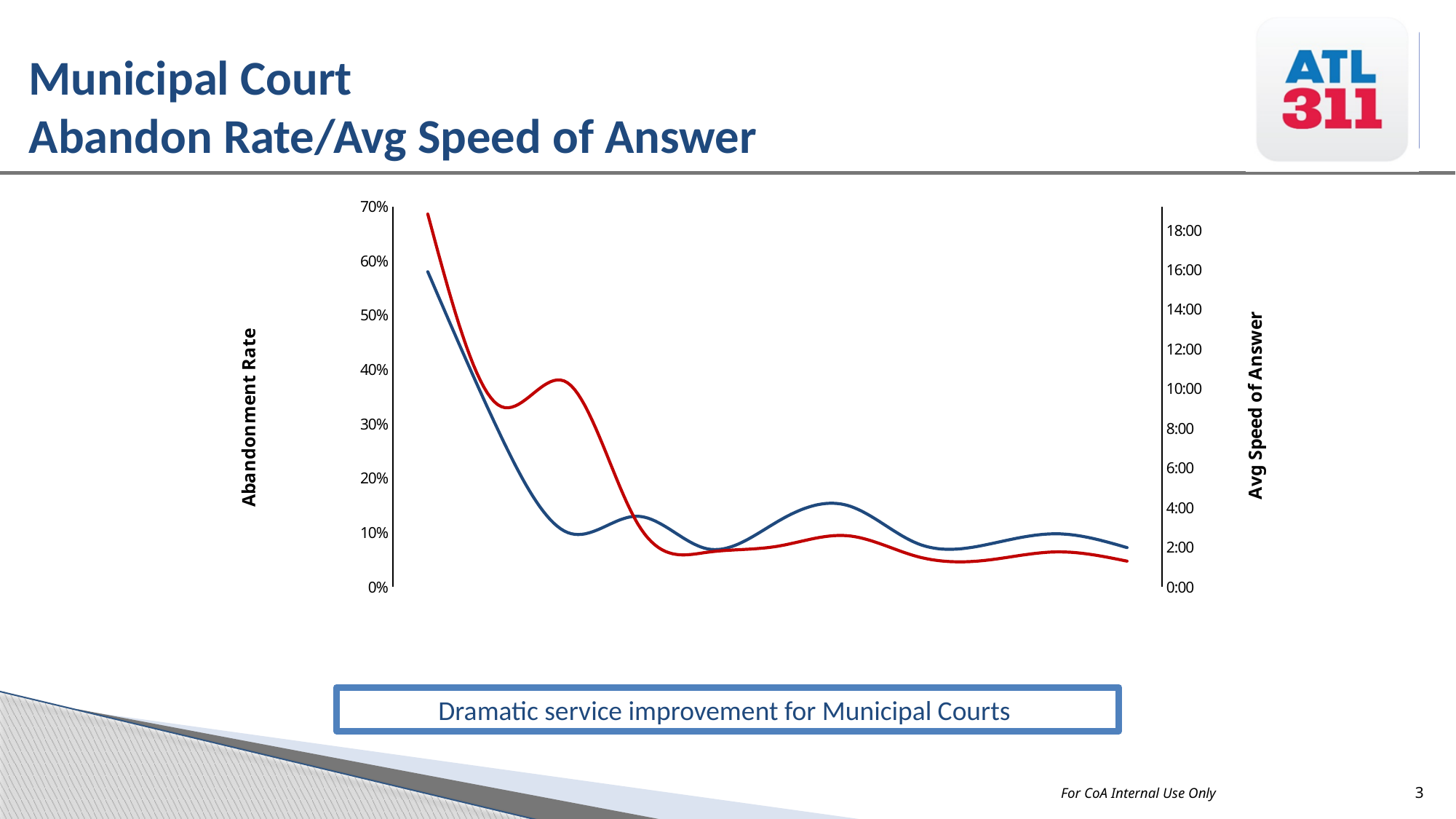
Do the plotted lines generally rise or fall from left to right? fall What kind of chart is shown on the slide? line chart What is the title of the right vertical axis? Avg Speed of Answer What is the highest tick value shown on the right axis (Avg Speed of Answer)? 18:00 What is the highest tick value shown on the left axis (Abandonment Rate)? 70% At its ending point on the right, is the blue line greater or less than 20% on the Abandonment Rate axis? less At its starting point on the left, is the red line greater or less than 60% on the Abandonment Rate axis? greater At its starting point on the left, is the blue line greater or less than 50% on the Abandonment Rate axis? greater At the far left of the chart, which line starts higher, the red line or the blue line? the red line